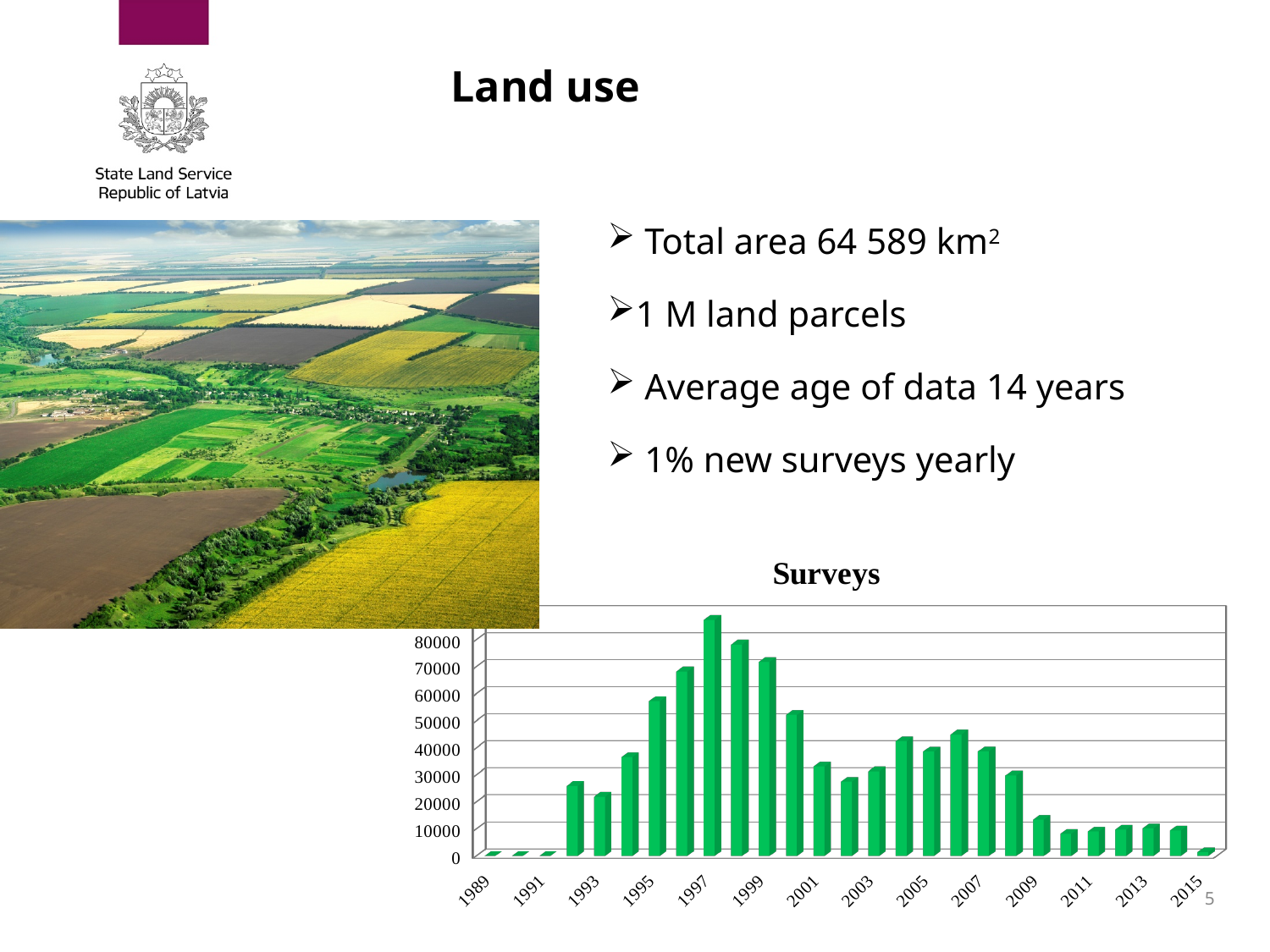
Which year has the highest number of surveys in the chart? 1997 Is the value for 1999 greater or less than 60000? greater Which year has the larger value, 1997 or 2007? 1997 Is the value for 2001 less or greater than 40000? less What is the title of the chart on the slide? Surveys Is the value for 1997 greater or less than 80000? greater What kind of chart is shown on the slide? bar chart Do the values generally rise or fall from 1997 to 2015? fall Which year has the larger value, 1995 or 2005? 1995